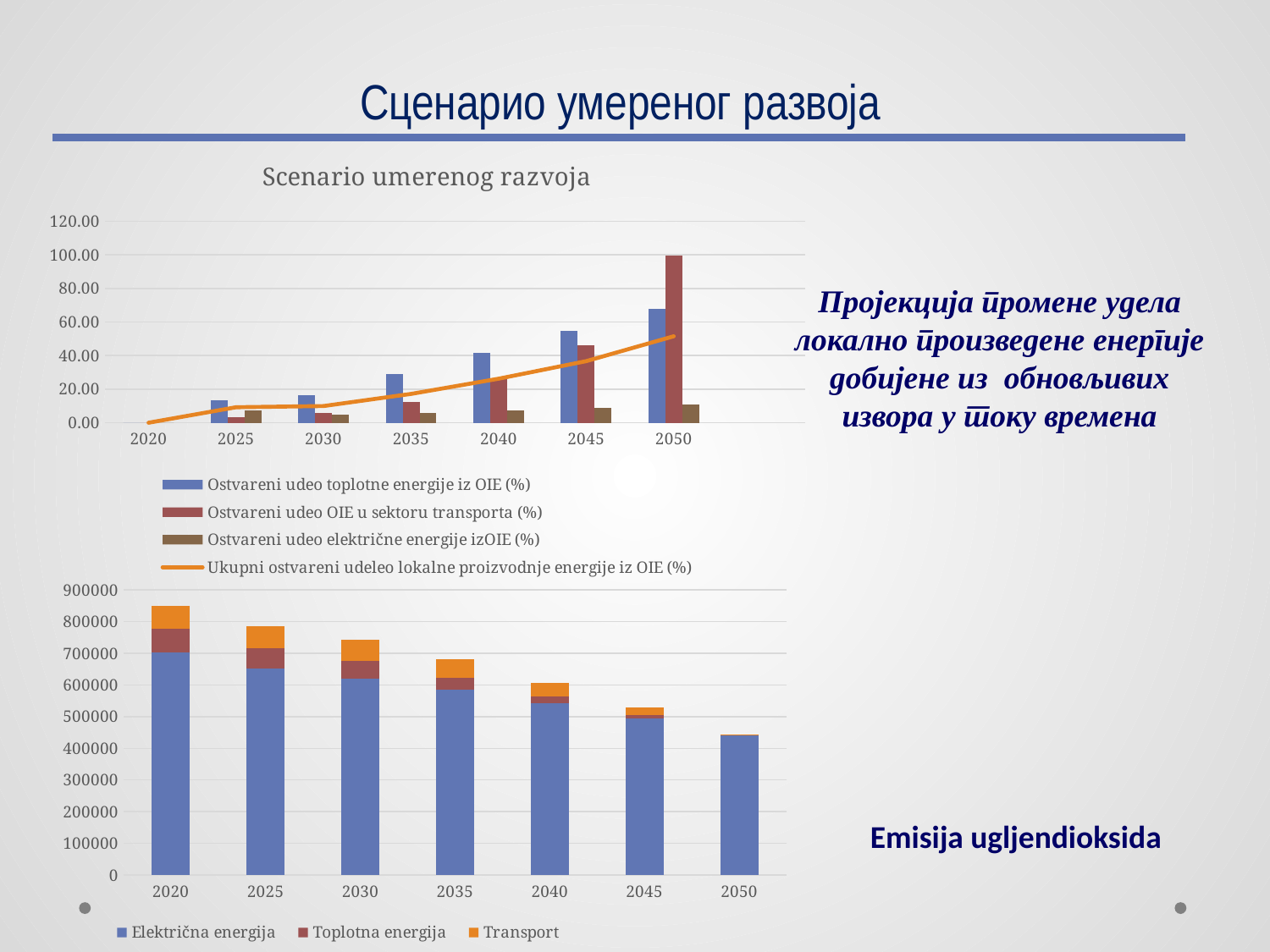
On the top chart titled 'Scenario umerenog razvoja', is the value of 'Ostvareni udeo toplotne energije iz OIE (%)' for 2050 greater or less than 60.00? greater On the bottom chart (Emisija ugljendioksida), is the total for 2050 greater or less than 500000? less On the top chart titled 'Scenario umerenog razvoja', does the line 'Ukupni ostvareni udeleo lokalne proizvodnje energije iz OIE (%)' rise or fall from 2020 to 2050? Rises On the top chart titled 'Scenario umerenog razvoja', in which year is 'Ostvareni udeo OIE u sektoru transporta (%)' highest? 2050 On the bottom chart (Emisija ugljendioksida), how many series does the legend list? 3 On the top chart titled 'Scenario umerenog razvoja', how many years are shown on the x axis? 7 On the top chart titled 'Scenario umerenog razvoja', what kind of chart is it? Bar chart with a line On the top chart titled 'Scenario umerenog razvoja', is the value of 'Ostvareni udeo OIE u sektoru transporta (%)' for 2050 greater or less than 80.00? greater On the bottom chart (Emisija ugljendioksida), do the total bar heights rise or fall from 2020 to 2050? Fall On the top chart titled 'Scenario umerenog razvoja', how many series does the legend list? 4 On the bottom chart (Emisija ugljendioksida), which year has the highest total bar? 2020 On the bottom chart (Emisija ugljendioksida), what kind of chart is it? Stacked bar chart